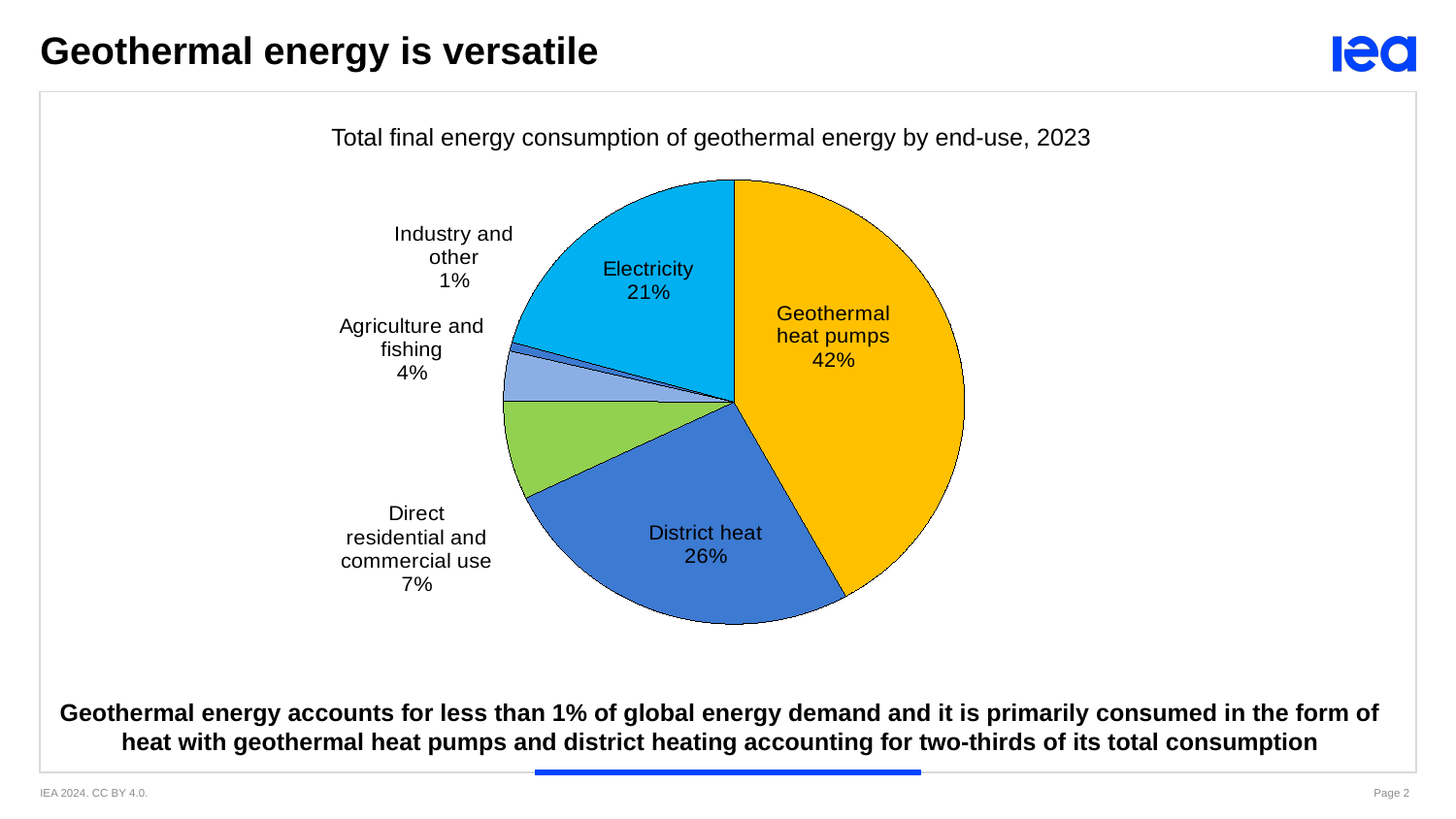
What type of chart is shown on the slide? Pie chart Which end-use has the largest share of geothermal energy consumption in the chart? Geothermal heat pumps Which is larger: the share for Electricity or the share for District heat? District heat Which end-use has the smallest share in the chart? Industry and other What share does Electricity account for in the chart? 21% What percentage of the pie chart is District heat? 26% What is the difference in percentage points between the Geothermal heat pumps share and the District heat share? 16 What percentage is shown for Agriculture and fishing? 4% What share of total final geothermal energy consumption in 2023 is attributed to geothermal heat pumps? 42% What is the title of the chart? Total final energy consumption of geothermal energy by end-use, 2023 How many end-use categories are shown in the pie chart? 6 What is the share for Direct residential and commercial use? 7%